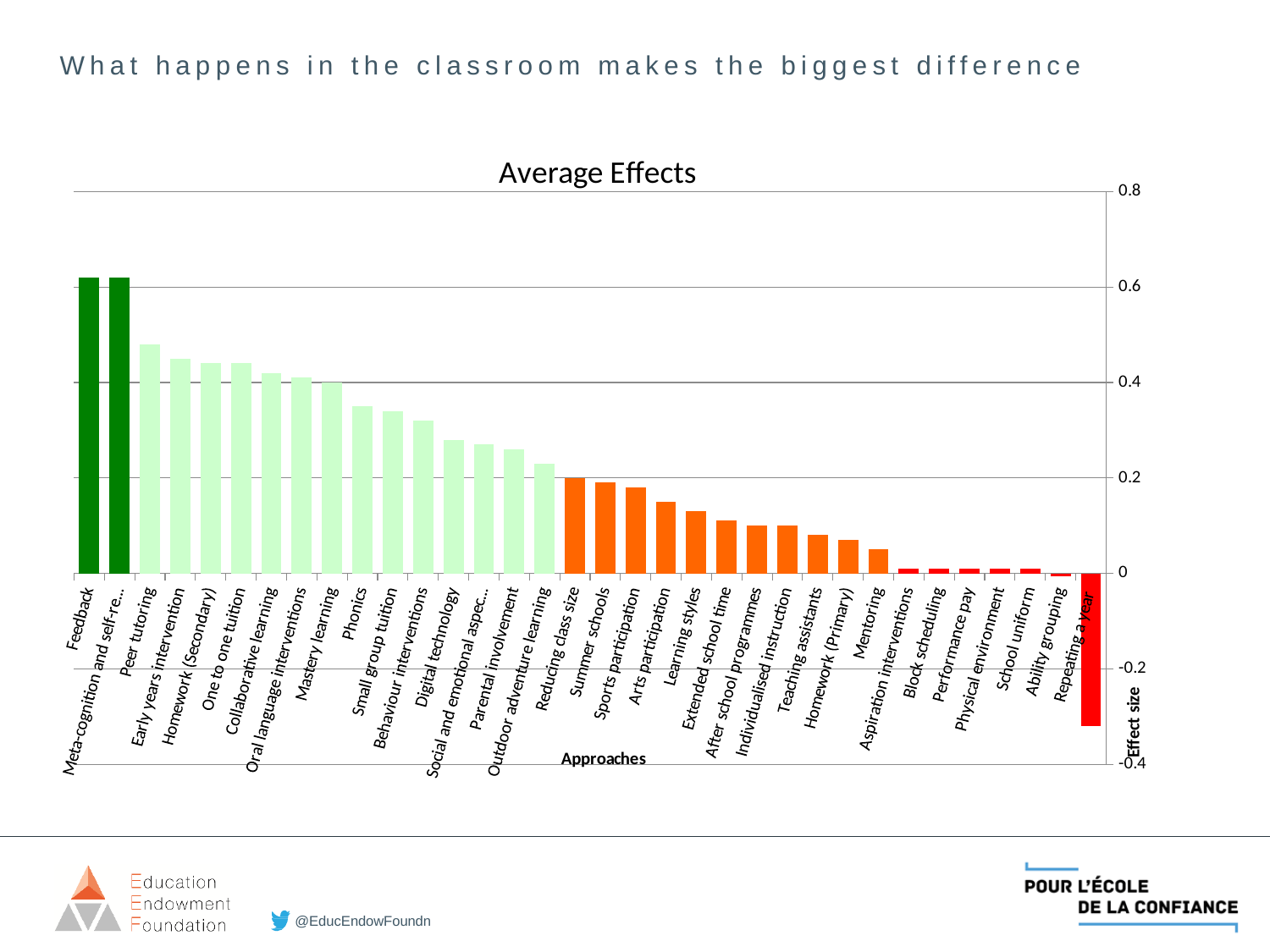
Is the value for Repeating a year greater or less than -0.2? less Do the values rise or fall moving from left to right along the x axis? fall Is the value for Peer tutoring greater or less than 0.6? less What is the title of the chart? Average Effects What kind of chart is shown on the slide? bar chart Which approach has the lowest average effect in the chart? Repeating a year Which has the larger value, Summer schools or Mentoring? Summer schools Is the value for Phonics greater or less than 0.4? less Which has the larger value, Peer tutoring or Phonics? Peer tutoring